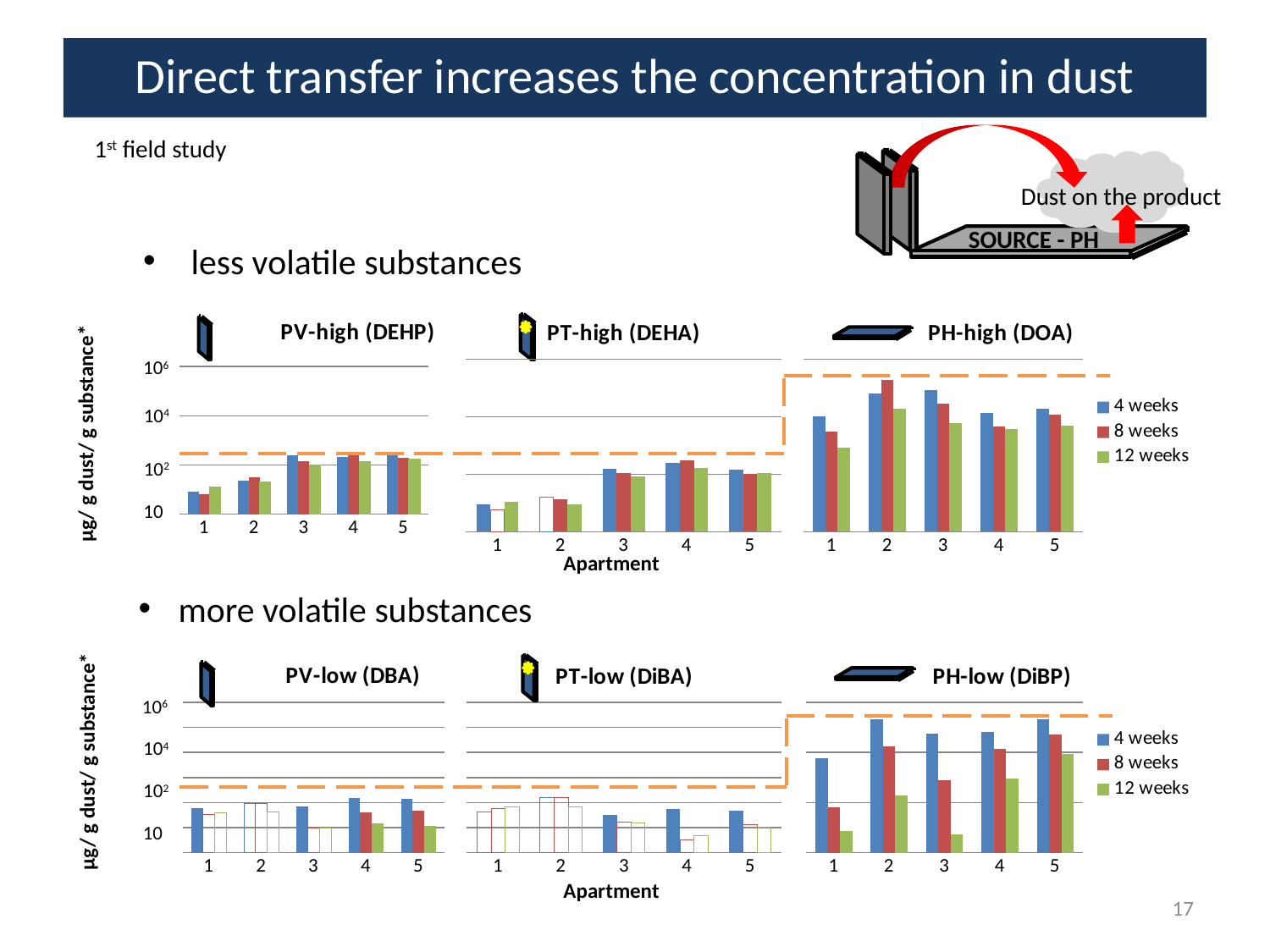
How many series does the legend next to the PH-high (DOA) chart list? 3 What kind of chart is the PH-high (DOA) chart? bar chart In the PH-high (DOA) chart, which apartment has the highest 8 weeks value? 2 In the PH-low (DiBP) chart, which is larger for apartment 1: the 4 weeks value or the 8 weeks value? 4 weeks In the PH-high (DOA) chart, is the 8 weeks value for apartment 2 greater or less than 10⁴? greater In the PH-low (DiBP) chart, is the 4 weeks value for apartment 2 greater or less than 10⁴? greater In the PT-high (DEHA) chart, is the 4 weeks value for apartment 1 greater or less than 100? less In the PH-high (DOA) chart, which apartment has the lowest 12 weeks value? 1 How many apartments are shown on the x axis of the PV-high (DEHP) chart? 5 What are the three legend entries shown next to the PH-high (DOA) chart? 4 weeks, 8 weeks, 12 weeks